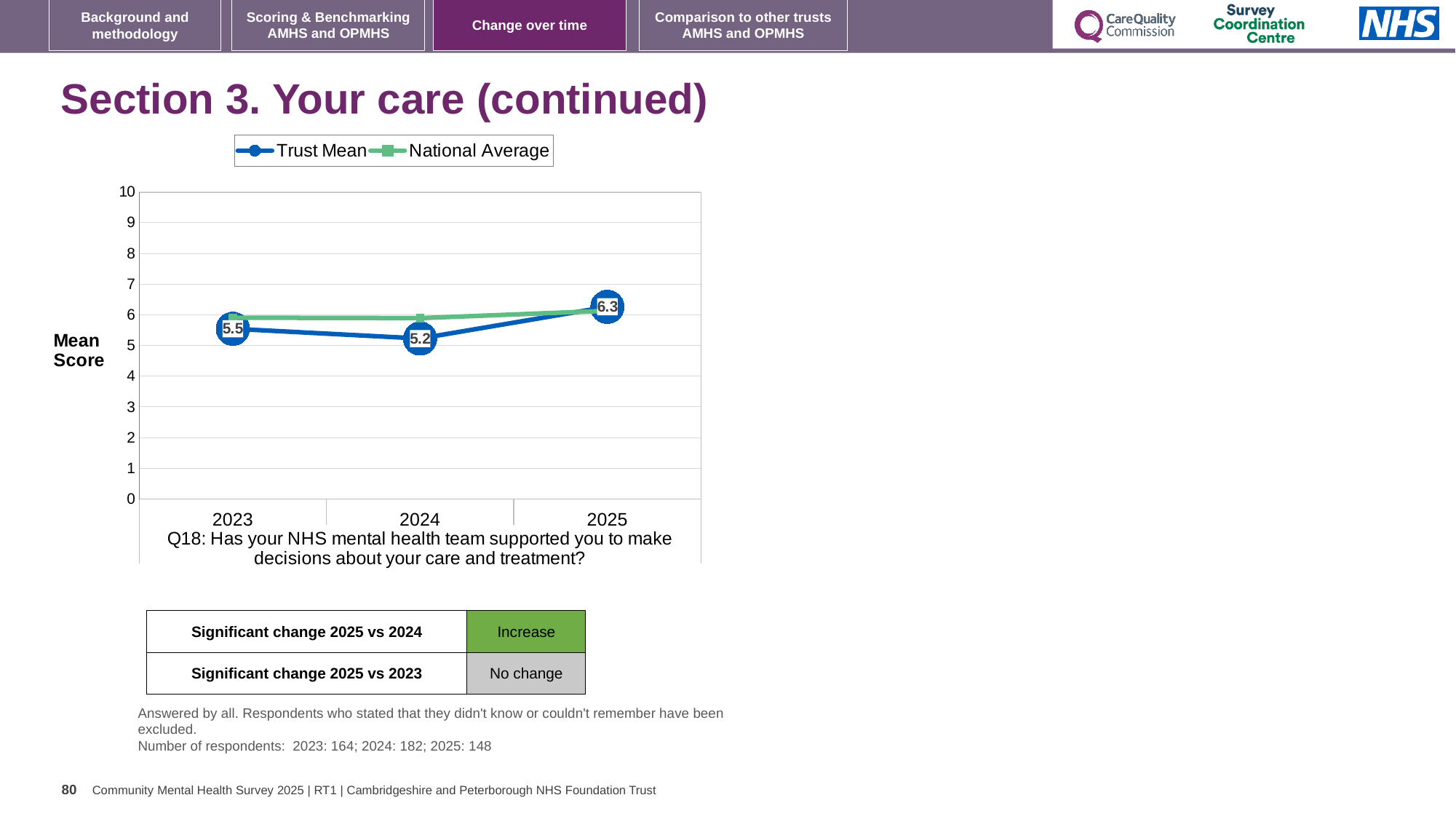
How many years are plotted on the x axis? 3 What is the Trust Mean score for 2025? 6.3 By how much did the Trust Mean score change from 2024 to 2025? 1.1 What is the Trust Mean score for 2023? 5.5 Is the National Average value for 2023 greater or less than 5? greater What is the Trust Mean score for 2024? 5.2 How many series does the legend list? 2 In which year is the Trust Mean score lowest? 2024 In which year is the Trust Mean score highest? 2025 In 2024, which is larger: the Trust Mean or the National Average? National Average What kind of chart is shown on the slide? Line chart What is the difference between the Trust Mean scores for 2023 and 2024? 0.3